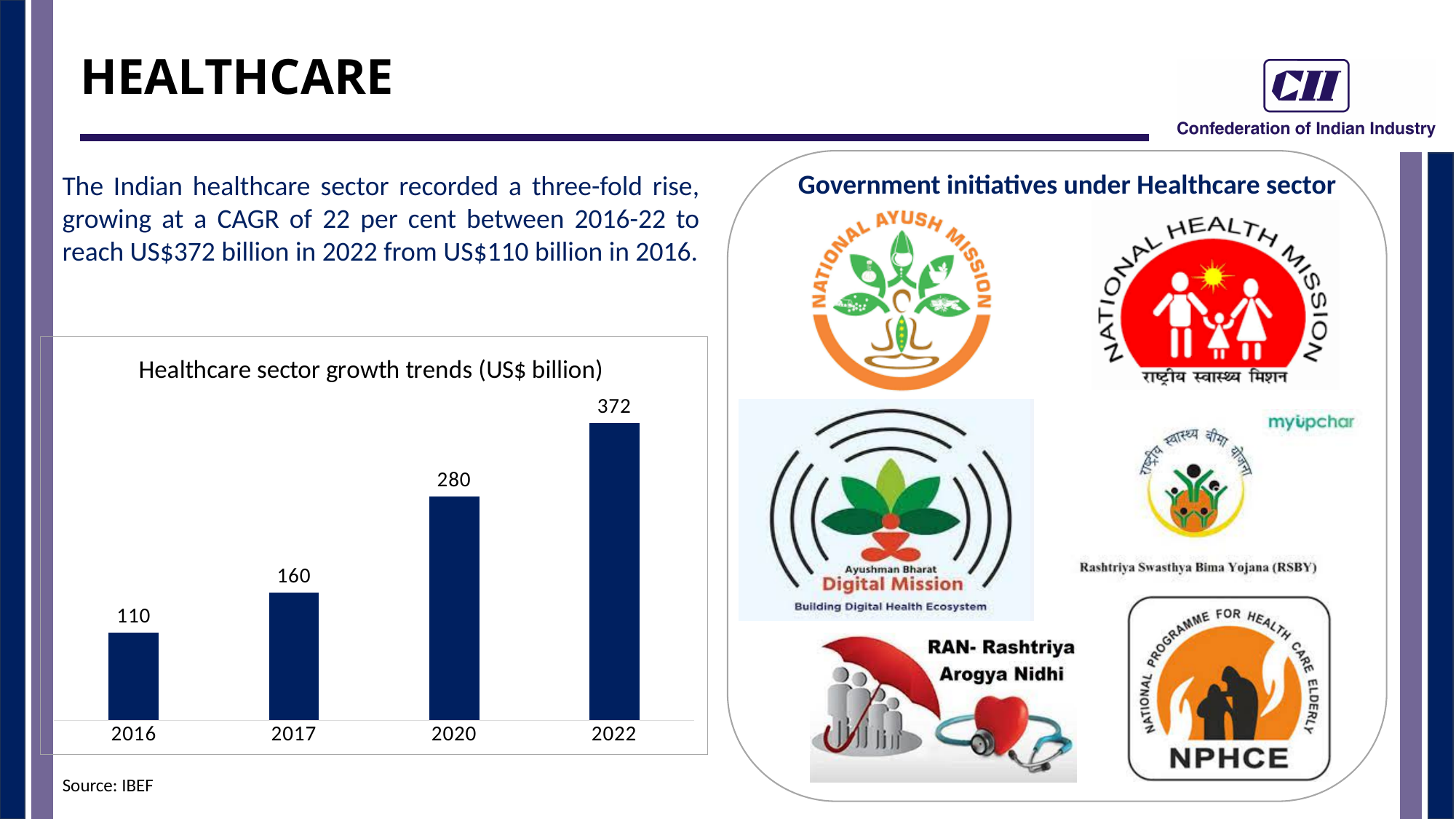
What is the value for 2017 in the Healthcare sector growth trends chart? 160 What is the value for 2016 in the Healthcare sector growth trends chart? 110 Do the values in the Healthcare sector growth trends chart rise or fall from 2016 to 2022? Rise What is the difference between the 2020 and 2017 values in the Healthcare sector growth trends chart? 120 What is the value for 2022 in the Healthcare sector growth trends chart? 372 What is the difference between the 2022 and 2016 values in the Healthcare sector growth trends chart? 262 What kind of chart is the Healthcare sector growth trends chart? Bar chart Which year has the highest value in the Healthcare sector growth trends chart? 2022 What is the value for 2020 in the Healthcare sector growth trends chart? 280 Which is larger in the Healthcare sector growth trends chart, the value for 2017 or the value for 2020? 2020 How many years are shown in the Healthcare sector growth trends chart? 4 Which year has the lowest value in the Healthcare sector growth trends chart? 2016